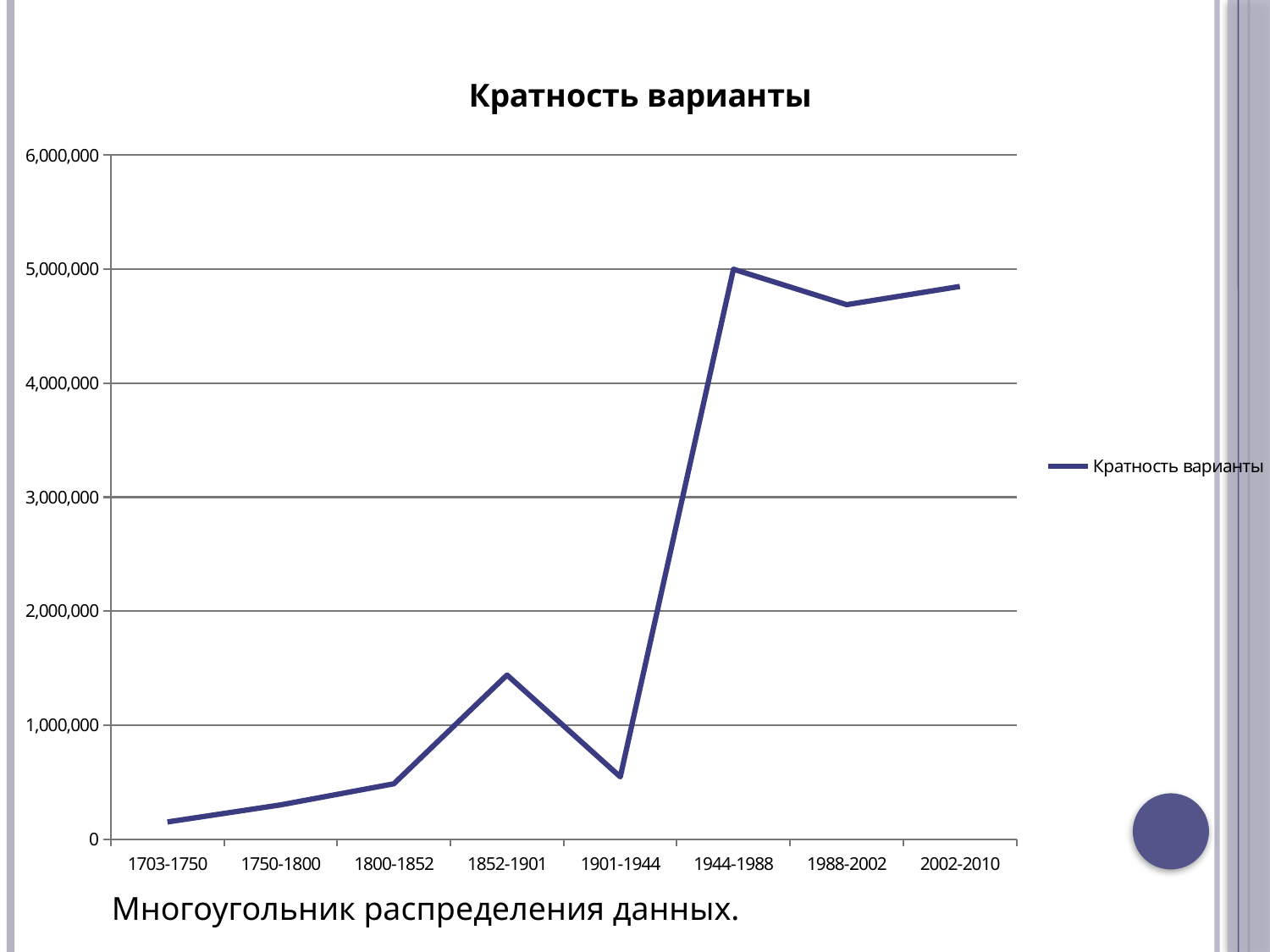
Is the value for 1852-1901 greater or less than 1,000,000? greater What is the title of the chart? Кратность варианты What kind of chart is shown on the slide? line chart Is the value for 1800-1852 greater or less than 1,000,000? less How many series does the legend list? 1 Which is larger, the value for 1852-1901 or the value for 1901-1944? 1852-1901 How many categories (periods) are shown on the x axis? 8 Is the value for 1988-2002 greater or less than 4,000,000? greater Which period has the highest value? 1944-1988 Overall, do the values rise or fall from 1703-1750 to 2002-2010? rise Which period has the lowest value? 1703-1750